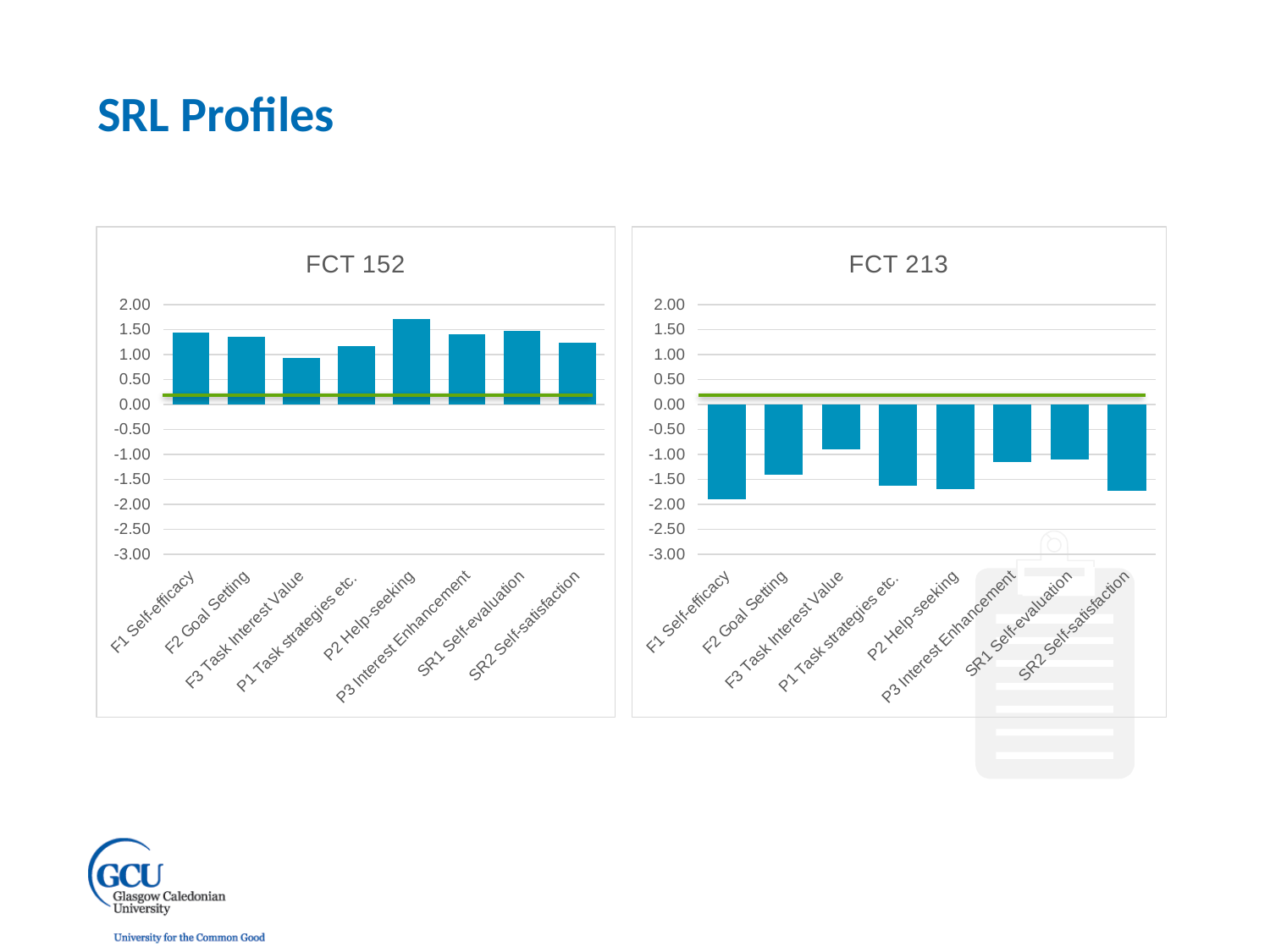
In the FCT 213 chart, which category has the highest value? F3 Task Interest Value In the FCT 152 chart, which category has the lowest value? F3 Task Interest Value How many categories are shown on the x axis of the FCT 213 chart? 8 In the FCT 152 chart, which category has the highest value? P2 Help-seeking In the FCT 213 chart, is the value for F1 Self-efficacy greater or less than -1.50? less In the FCT 152 chart, which is larger, the value for F1 Self-efficacy or the value for F3 Task Interest Value? F1 Self-efficacy In the FCT 152 chart, is the value for P2 Help-seeking greater or less than 1.50? greater What are the titles of the two charts on the slide? FCT 152 and FCT 213 What kind of chart is the FCT 152 chart? bar chart In the FCT 213 chart, which category has the lowest value? F1 Self-efficacy In the FCT 213 chart, is the value for P3 Interest Enhancement greater or less than -1.50? greater